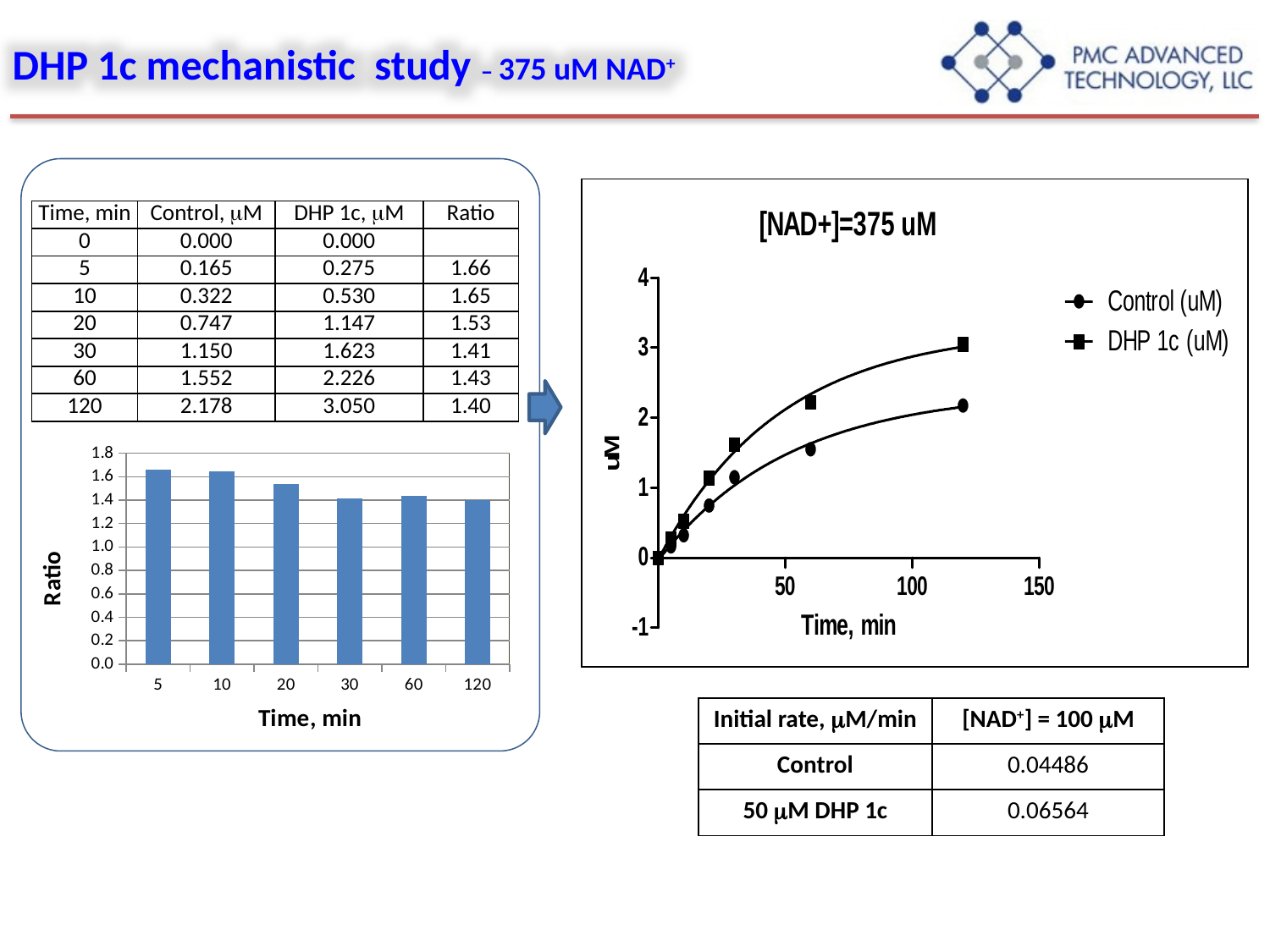
In the Ratio bar chart on the left, which is larger, the value for 5 min or the value for 120 min? 5 min How many series does the legend of the chart titled [NAD+]=375 uM list? 2 In the Ratio bar chart on the left, how many bars are plotted? 6 In the Ratio bar chart on the left, is the value for 20 min greater or less than 1.4? greater In the Ratio bar chart on the left, is the value for 5 min greater or less than 1.4? greater In the chart titled [NAD+]=375 uM, is the Control (uM) value at 120 min greater or less than 3? less What is the y axis label of the chart titled [NAD+]=375 uM? uM In the chart titled [NAD+]=375 uM, which series is higher at 120 min, Control (uM) or DHP 1c (uM)? DHP 1c (uM) In the Ratio bar chart on the left, do the values generally rise or fall as time increases along the x axis? fall What kind of chart is the chart titled [NAD+]=375 uM? line chart What kind of chart is the chart on the left of the slide with the y axis labelled Ratio? bar chart